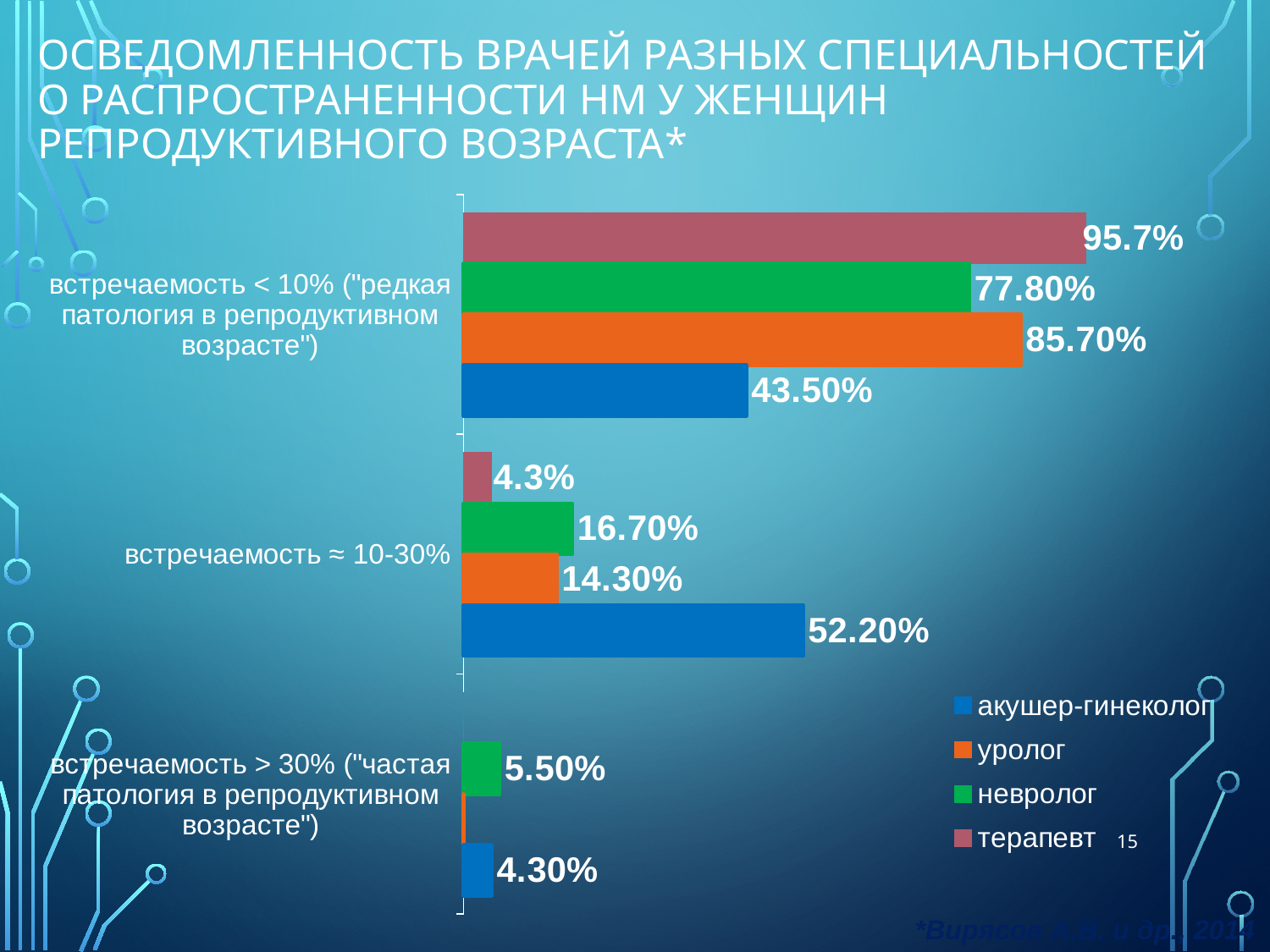
Which series has the lowest value in the category встречаемость ≈ 10-30%? терапевт How many series does the legend list? 4 In the category встречаемость ≈ 10-30%, which is larger: the value for невролог or the value for уролог? невролог What is the value for акушер-гинеколог in the category встречаемость ≈ 10-30%? 52.20% What is the value for уролог in the category встречаемость < 10% ("редкая патология в репродуктивном возрасте")? 85.70% How many categories are shown on the chart? 3 What is the value for терапевт in the category встречаемость < 10% ("редкая патология в репродуктивном возрасте")? 95.7% Which series has the highest value in the category встречаемость < 10% ("редкая патология в репродуктивном возрасте")? терапевт Which colour represents the series акушер-гинеколог in the legend? blue What kind of chart is shown on the slide? bar chart What is the value for невролог in the category встречаемость > 30% ("частая патология в репродуктивном возрасте")? 5.50% What is the difference between the уролог and невролог values in the category встречаемость < 10% ("редкая патология в репродуктивном возрасте")? 7.90%